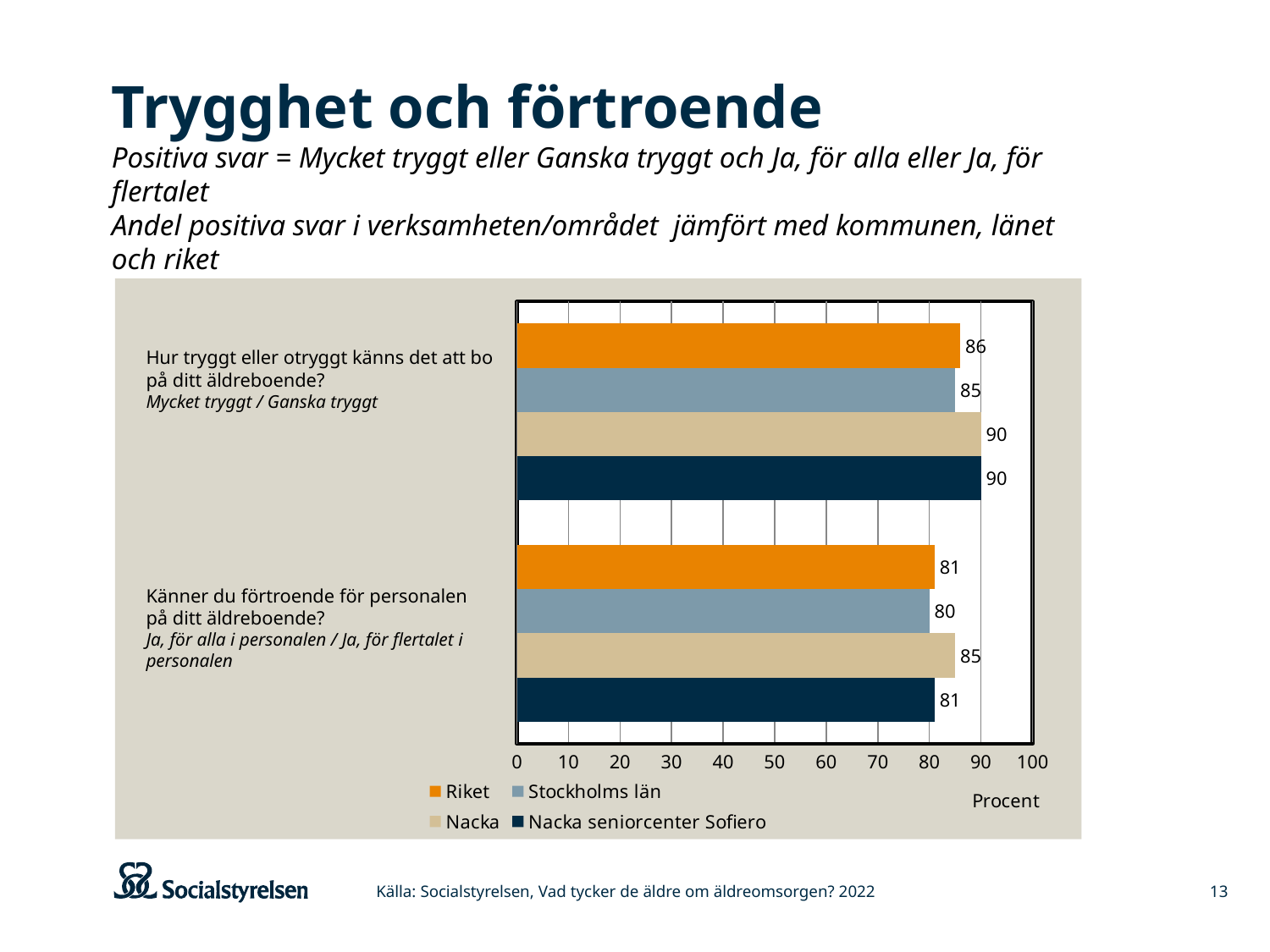
What is the value for Riket on the question "Hur tryggt eller otryggt känns det att bo på ditt äldreboende?"? 86 What is the value for Nacka on the question "Hur tryggt eller otryggt känns det att bo på ditt äldreboende?"? 90 How many series does the legend list? 4 What is the difference between the Nacka seniorcenter Sofiero value and the Stockholms län value on the question "Hur tryggt eller otryggt känns det att bo på ditt äldreboende?"? 5 What kind of chart is shown on the slide? Bar chart Which series has the lowest value on the question "Känner du förtroende för personalen på ditt äldreboende?"? Stockholms län Which series has the highest value on the question "Känner du förtroende för personalen på ditt äldreboende?"? Nacka What is the value for Stockholms län on the question "Känner du förtroende för personalen på ditt äldreboende?"? 80 What unit label is shown below the x axis of the chart? Procent Is the value for Nacka seniorcenter Sofiero on the question "Hur tryggt eller otryggt känns det att bo på ditt äldreboende?" larger than its value on the question "Känner du förtroende för personalen på ditt äldreboende?"? Yes What is the value for Nacka seniorcenter Sofiero on the question "Känner du förtroende för personalen på ditt äldreboende?"? 81 What is the difference between the Nacka value and the Riket value on the question "Känner du förtroende för personalen på ditt äldreboende?"? 4